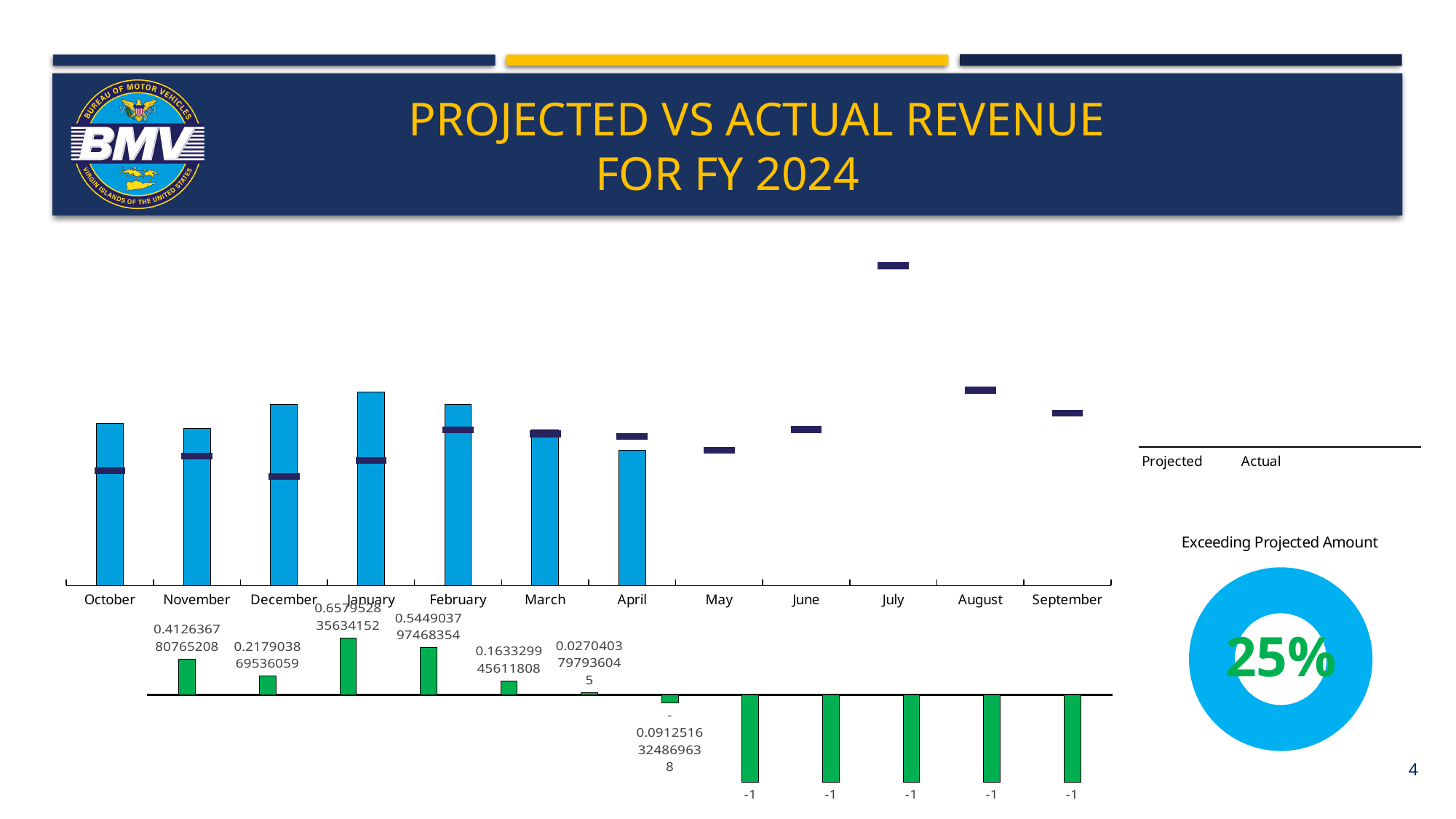
In the Projected vs Actual Revenue chart, how many months are shown on the x axis? 12 What kind of chart is the lower green chart on the slide? bar chart What is the title of the slide's main chart? Projected vs Actual Revenue for FY 2024 In the Projected vs Actual Revenue chart, which month has the tallest Actual bar? January In the Projected vs Actual Revenue chart, which month has the highest Projected marker? July In the lower green bar chart, what is the data label on the third bar from the left? 0.657952835634152 In the lower green bar chart, how many bars are labelled -1? 5 What percentage is shown in the 'Exceeding Projected Amount' donut chart? 25% In the Projected vs Actual Revenue chart, how many months have an Actual bar plotted? 7 In the Projected vs Actual Revenue chart, for October, is the Actual value larger or smaller than the Projected value? larger In the Projected vs Actual Revenue chart, for April, which is larger: Projected or Actual? Projected